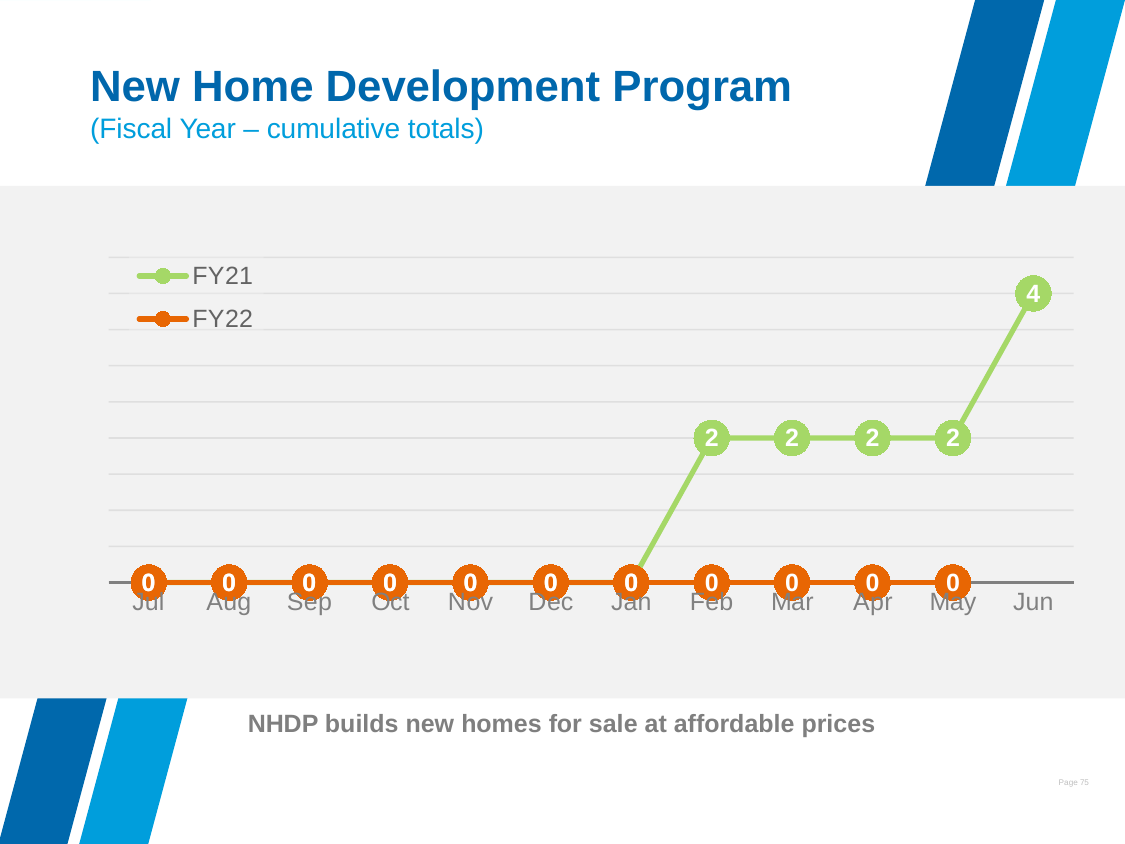
In which month does the FY21 series reach its highest value? Jun What is the FY21 value for Jun? 4 Which is larger, the FY21 value for Apr or the FY22 value for Apr? FY21 What is the FY21 value for Feb? 2 Which series is drawn in orange? FY22 What is the FY22 value for May? 0 What is the FY21 value for Jan? 0 Does the FY21 series rise or fall from Jan to Jun? rise How many series does the legend list? 2 What type of chart is shown on the slide? line chart How many months are shown on the x axis? 12 What is the difference between the FY21 values for Jun and May? 2